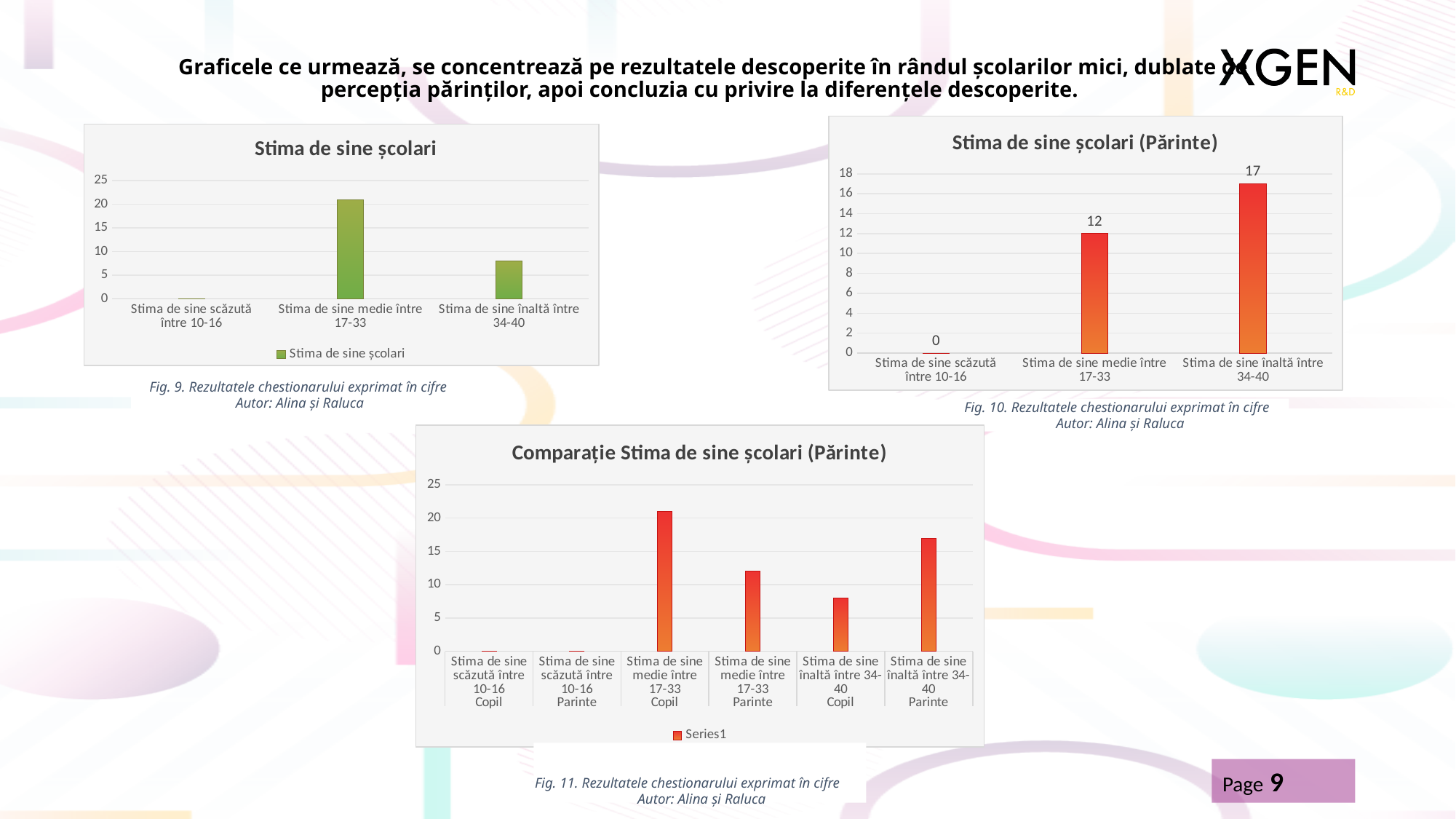
In the chart titled 'Stima de sine școlari', is the value for 'Stima de sine medie între 17-33' greater or less than 20? greater In the chart titled 'Stima de sine școlari (Părinte)', what is the value for 'Stima de sine medie între 17-33'? 12 How many categories are shown in the chart titled 'Comparație Stima de sine școlari (Părinte)'? 6 In the chart titled 'Stima de sine școlari', which category has the highest value? Stima de sine medie între 17-33 In the chart titled 'Stima de sine școlari (Părinte)', what is the value for 'Stima de sine înaltă între 34-40'? 17 What is the legend entry shown in the chart titled 'Comparație Stima de sine școlari (Părinte)'? Series1 In the chart titled 'Stima de sine școlari', is the value for 'Stima de sine înaltă între 34-40' greater or less than 10? less In the chart titled 'Stima de sine școlari (Părinte)', what is the value for 'Stima de sine scăzută între 10-16'? 0 In the chart titled 'Comparație Stima de sine școlari (Părinte)', which is larger: the value for 'Stima de sine medie între 17-33 Copil' or 'Stima de sine medie între 17-33 Parinte'? Stima de sine medie între 17-33 Copil In the chart titled 'Stima de sine școlari (Părinte)', which category has the highest value? Stima de sine înaltă între 34-40 What type of chart is the chart titled 'Stima de sine școlari'? Bar chart In the chart titled 'Stima de sine școlari (Părinte)', what is the difference between the values for 'Stima de sine înaltă între 34-40' and 'Stima de sine medie între 17-33'? 5